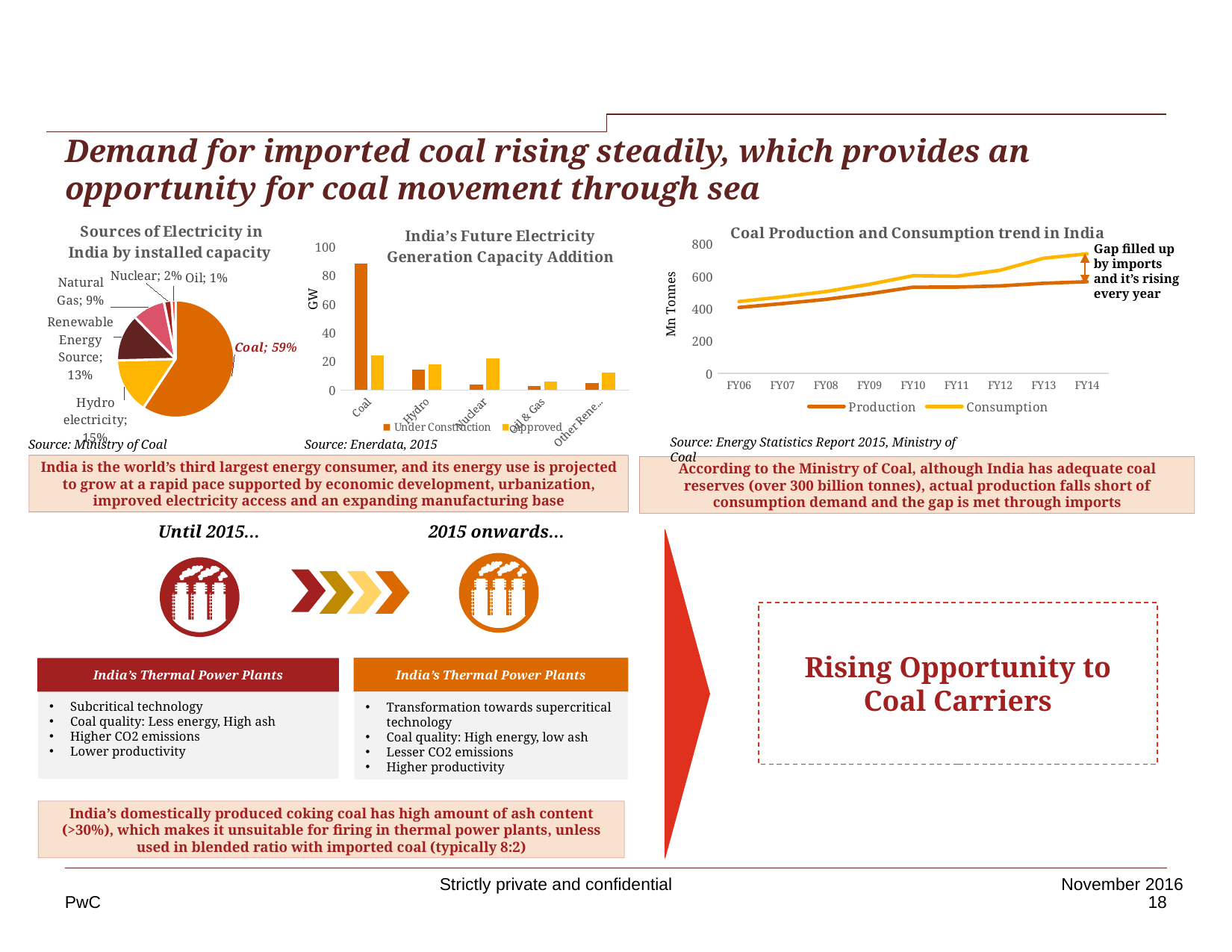
How many slices does the pie chart 'Sources of Electricity in India by installed capacity' have? 6 In 'India's Future Electricity Generation Capacity Addition', is the Under Construction value for Coal greater or less than 80 GW? greater In 'India's Future Electricity Generation Capacity Addition', which category has the highest Under Construction value? Coal In the pie chart 'Sources of Electricity in India by installed capacity', how many percentage points larger is Coal's share than Hydro electricity's share? 44 In the pie chart 'Sources of Electricity in India by installed capacity', which source has the smallest share? Oil In the pie chart 'Sources of Electricity in India by installed capacity', what is the share of Natural Gas? 9% In 'Coal Production and Consumption trend in India', which series is higher in FY14, Production or Consumption? Consumption In 'Coal Production and Consumption trend in India', does Consumption rise or fall from FY06 to FY14? rise In the pie chart 'Sources of Electricity in India by installed capacity', which source has the largest share? Coal In the pie chart 'Sources of Electricity in India by installed capacity', what share does Coal have? 59% How many series does the legend of 'India's Future Electricity Generation Capacity Addition' list? 2 What kind of chart is 'India's Future Electricity Generation Capacity Addition'? bar chart